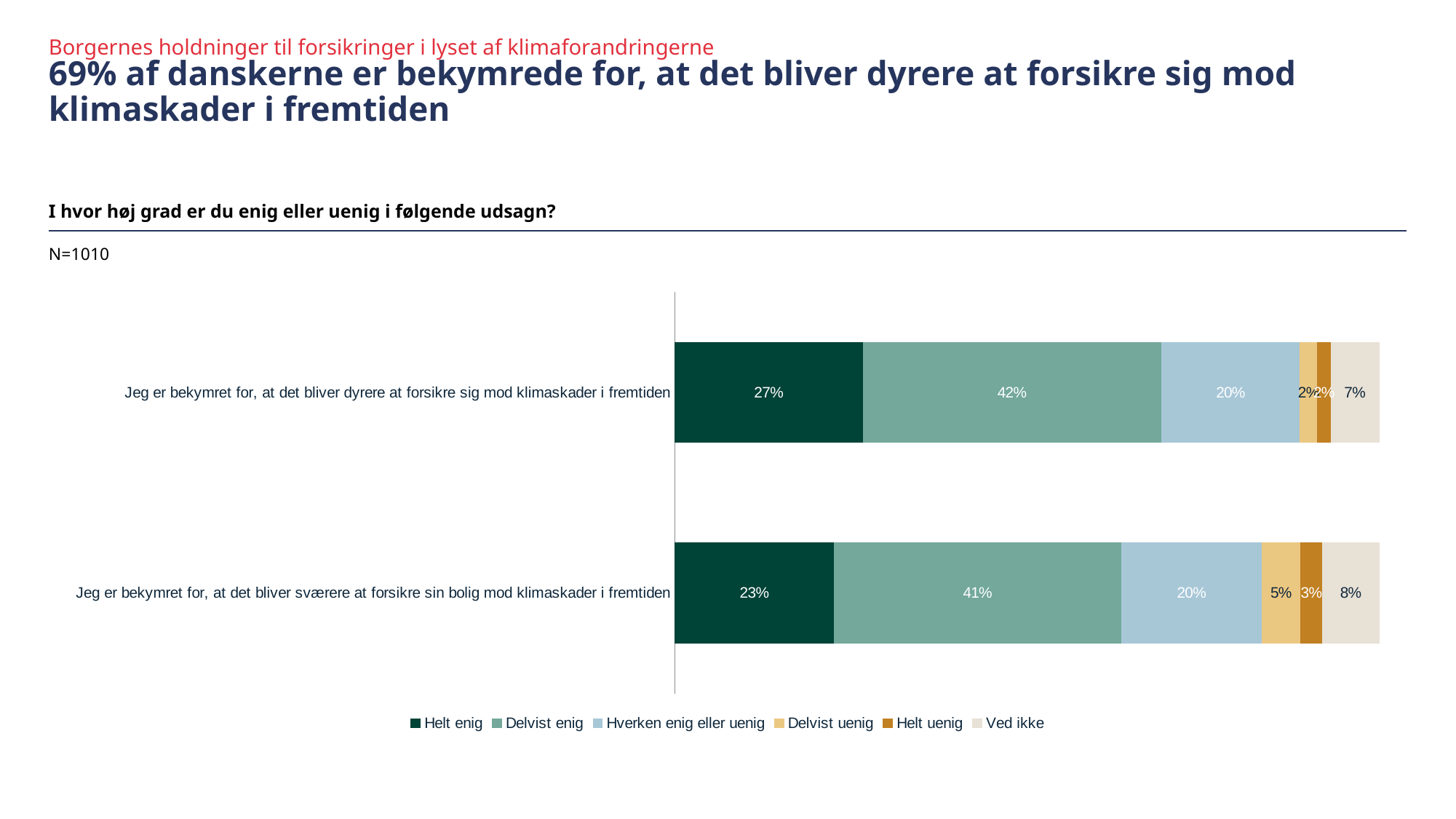
What is the 'Helt enig' value for 'Jeg er bekymret for, at det bliver dyrere at forsikre sig mod klimaskader i fremtiden'? 27% What is the 'Delvist enig' value for 'Jeg er bekymret for, at det bliver sværere at forsikre sin bolig mod klimaskader i fremtiden'? 41% How many series does the legend list? 6 What is the sample size (N) stated on the slide? N=1010 What is the 'Delvist uenig' value for 'Jeg er bekymret for, at det bliver sværere at forsikre sin bolig mod klimaskader i fremtiden'? 5% What is the 'Ved ikke' value for 'Jeg er bekymret for, at det bliver sværere at forsikre sin bolig mod klimaskader i fremtiden'? 8% What kind of chart is shown on the slide? Stacked bar chart How many statements (categories) are plotted in the chart? 2 Which series is the largest segment in the bar for 'Jeg er bekymret for, at det bliver dyrere at forsikre sig mod klimaskader i fremtiden'? Delvist enig What is the combined share of 'Helt enig' and 'Delvist enig' for 'Jeg er bekymret for, at det bliver sværere at forsikre sin bolig mod klimaskader i fremtiden'? 64% What is the difference between the 'Helt enig' values of the two statements? 4 percentage points Which statement has the higher 'Helt enig' share? Jeg er bekymret for, at det bliver dyrere at forsikre sig mod klimaskader i fremtiden